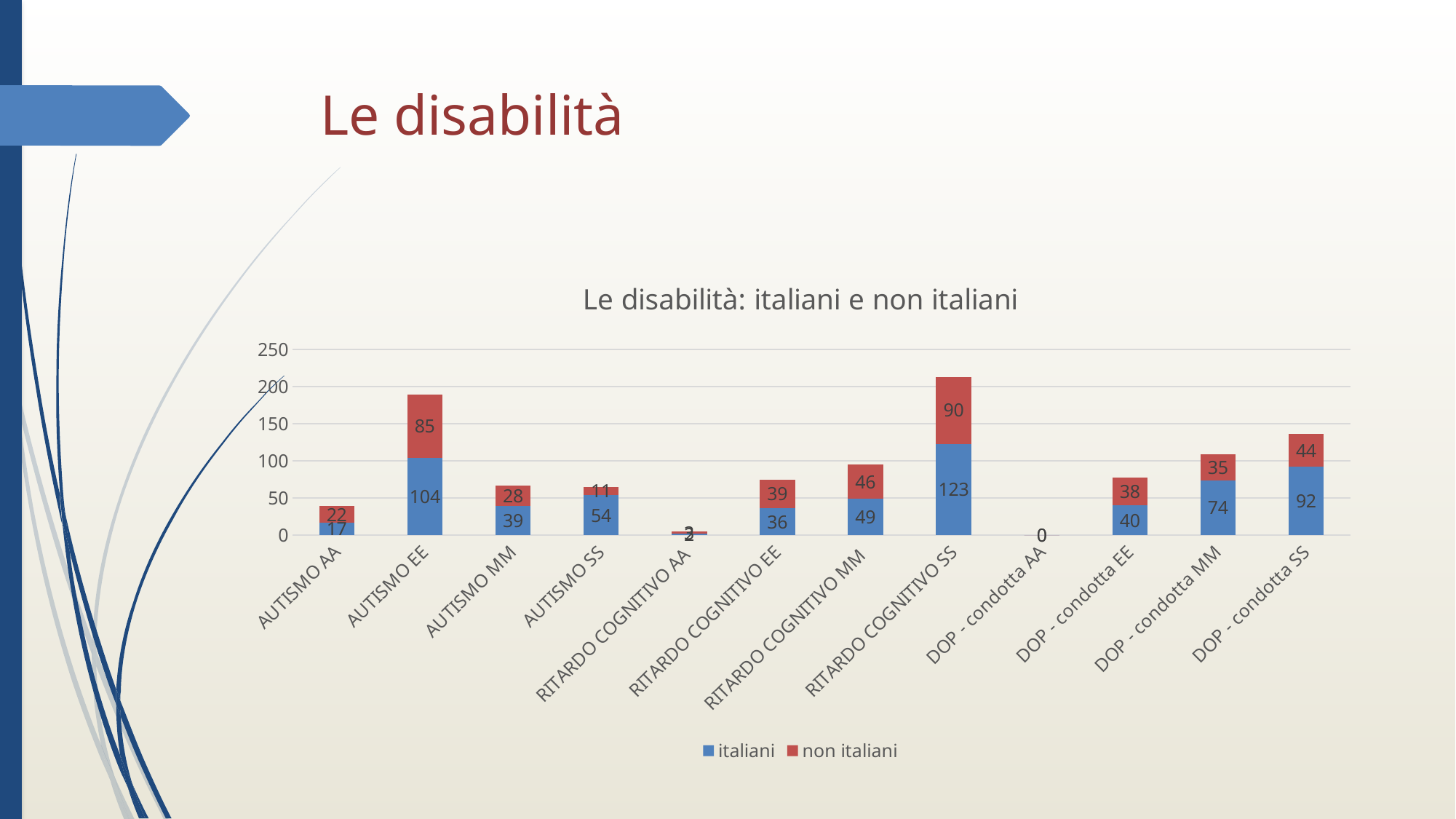
Which category has the tallest stacked bar overall? RITARDO COGNITIVO SS Which category has the highest italiani value? RITARDO COGNITIVO SS What is the non italiani value for AUTISMO EE? 85 What kind of chart is shown on the slide? stacked bar chart What is the difference between the italiani and non italiani values for DOP - condotta SS? 48 What is the italiani value for DOP - condotta MM? 74 Which is larger for AUTISMO AA, the italiani value or the non italiani value? non italiani How many categories are shown on the x axis? 12 What is the italiani value for RITARDO COGNITIVO SS? 123 How many series does the legend list? 2 What is the total of the stacked bar for AUTISMO EE? 189 What is the non italiani value for AUTISMO SS? 11